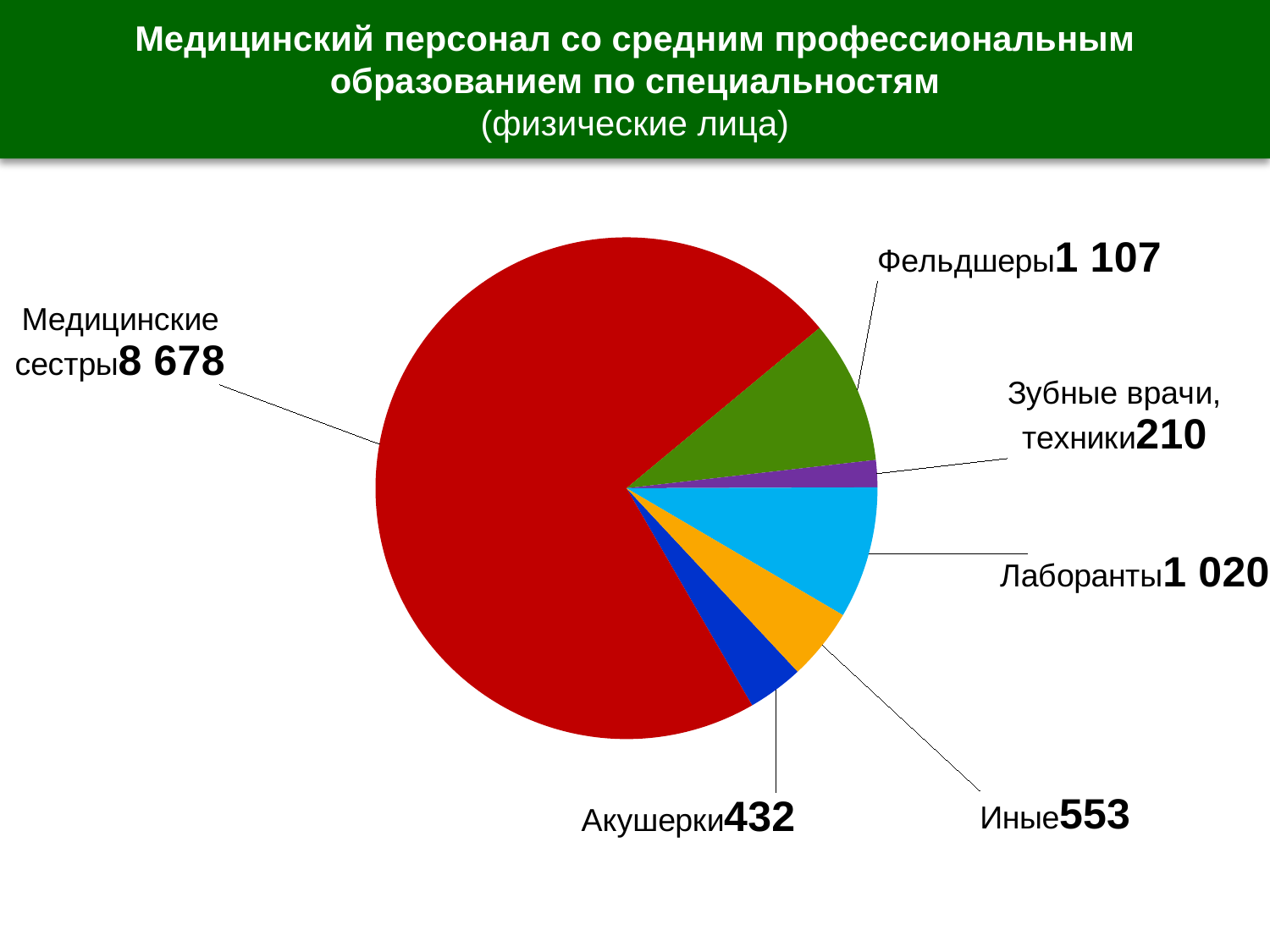
What is the difference between Иные and Акушерки? 121 What is the value for Зубные врачи, техники? 210 What is the value for Медицинские сестры? 8 678 What is the value for Акушерки? 432 How many slices does the pie chart have? 6 What is the value for Фельдшеры? 1 107 Which is larger, Фельдшеры or Лаборанты? Фельдшеры Which category has the smallest slice? Зубные врачи, техники What kind of chart is shown on the slide? Pie chart Which category has the largest slice? Медицинские сестры What colour is the slice for Медицинские сестры? Red What is the difference between Фельдшеры and Лаборанты? 87